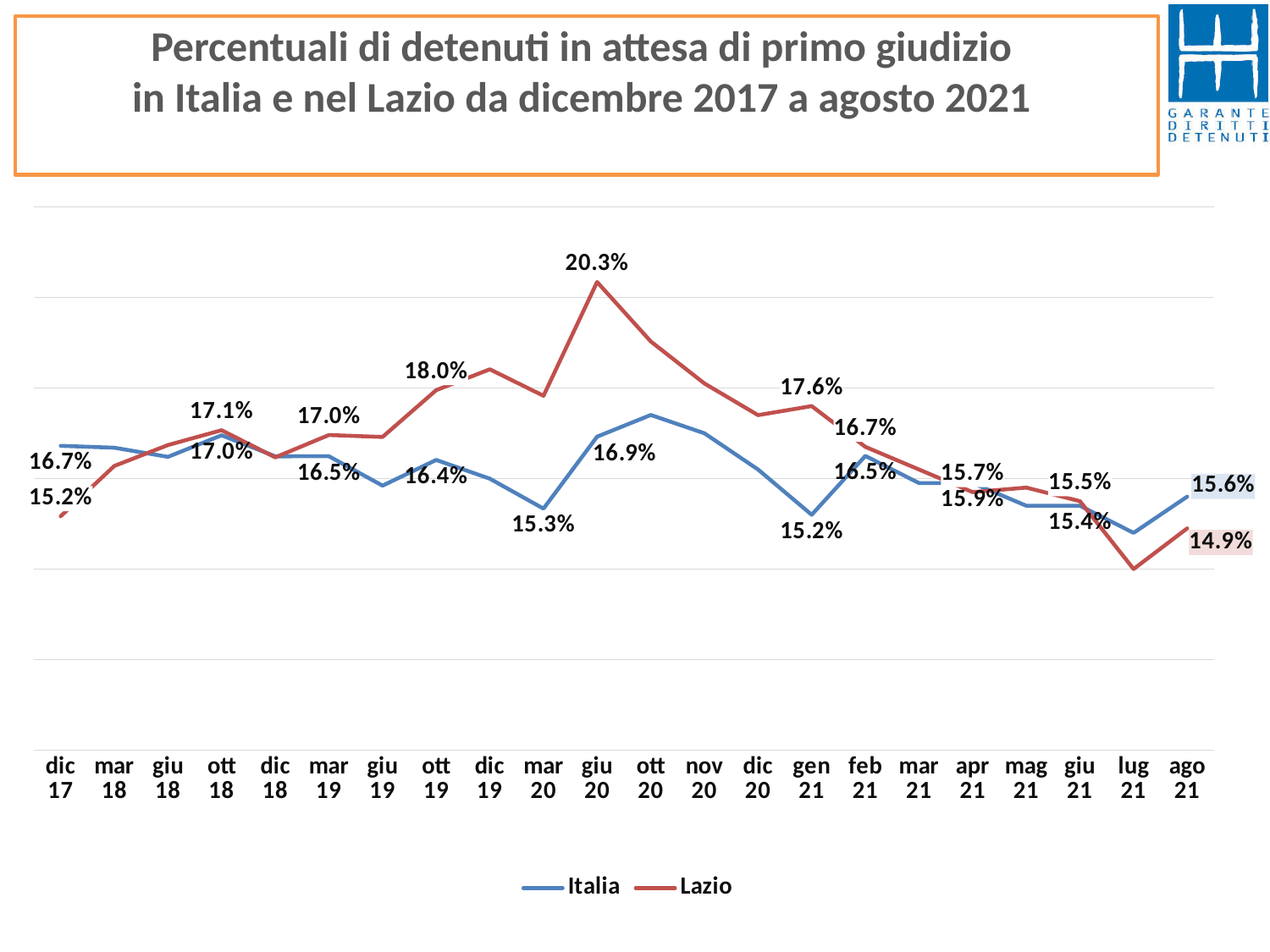
What is the difference between Lazio and Italia in giu 20? 3.4 percentage points What is the value for Italia in mar 20? 15.3% What is the value for Lazio in ago 21? 14.9% How many time points are shown on the x axis? 22 In which month does the Lazio series reach its highest value? giu 20 How many series does the legend list? 2 In gen 21, which series has the higher value, Italia or Lazio? Lazio What is the value for Lazio in giu 20? 20.3% In which month does the Lazio series reach its lowest value? lug 21 What kind of chart is shown on the slide? line chart What is the value for Italia in dic 17? 16.7% Which colour is used for the Lazio series? red